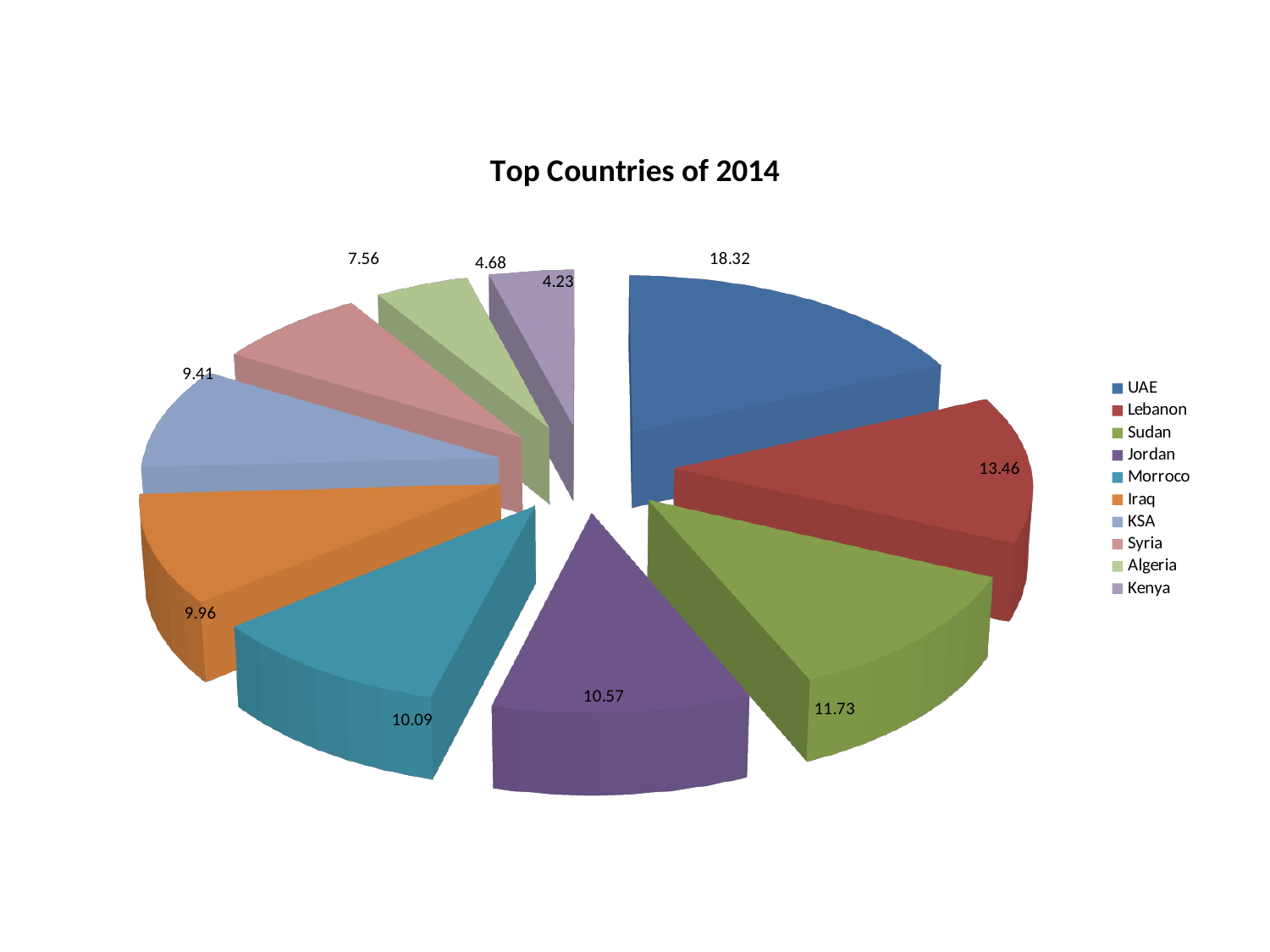
What kind of chart is shown on the slide? Pie chart Which country has the smallest slice? Kenya What is the value for UAE? 18.32 What is the value for Morroco? 10.09 Which has the larger value, Morroco or Iraq? Morroco What is the value for Syria? 7.56 What is the value for Kenya? 4.23 What is the difference between the values for UAE and Lebanon? 4.86 Which country has the largest slice? UAE How many countries are shown in the pie chart? 10 What is the difference between the values for Algeria and Kenya? 0.45 What is the title of the chart? Top Countries of 2014